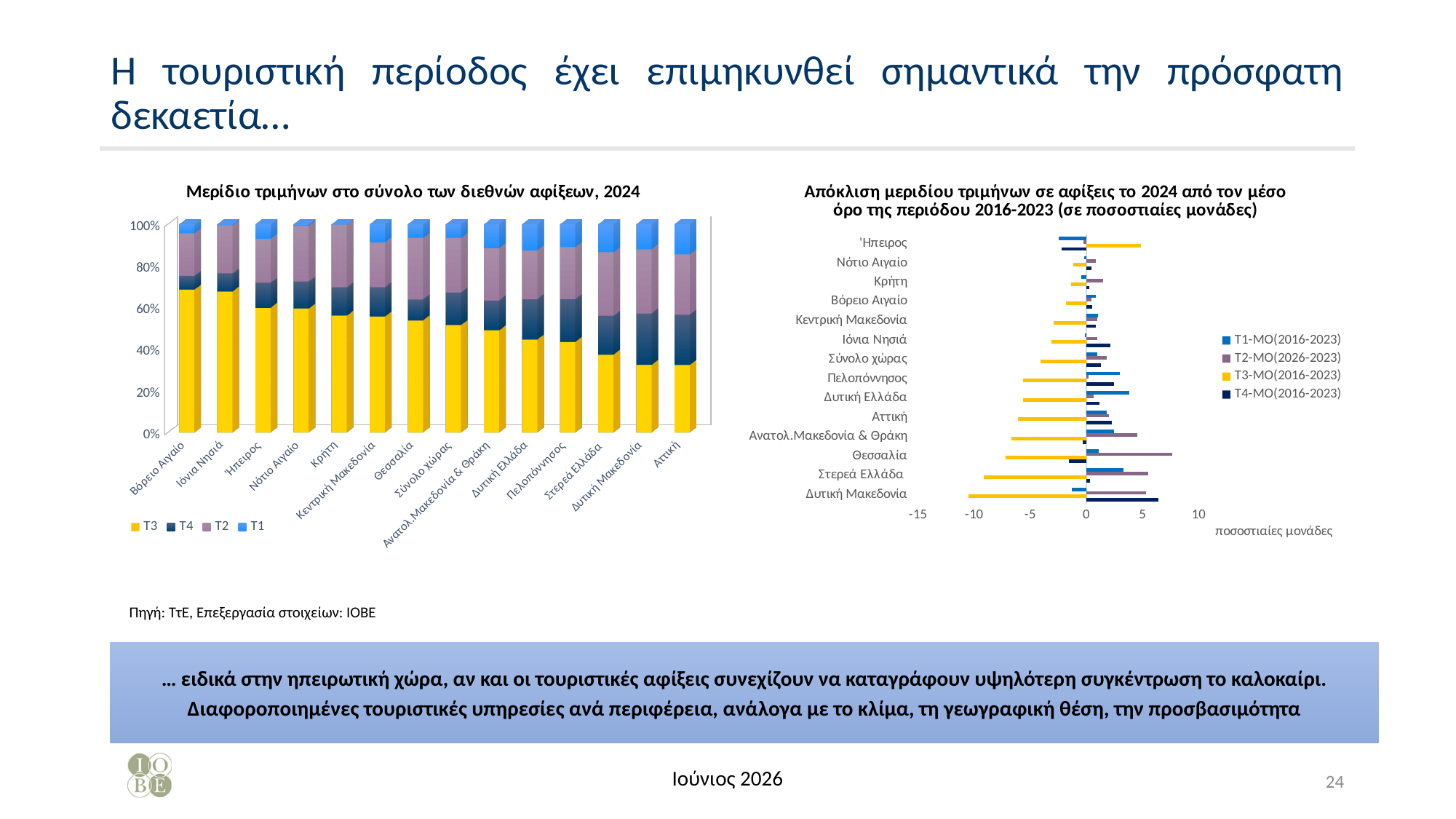
In the left chart 'Μερίδιο τριμήνων στο σύνολο των διεθνών αφίξεων, 2024', which has the larger Τ3 share: Βόρειο Αιγαίο or Αττική? Βόρειο Αιγαίο What kind of chart is the left chart titled 'Μερίδιο τριμήνων στο σύνολο των διεθνών αφίξεων, 2024'? Stacked bar chart In the left chart 'Μερίδιο τριμήνων στο σύνολο των διεθνών αφίξεων, 2024', how many series does the legend list? 4 What kind of chart is the right chart titled 'Απόκλιση μεριδίου τριμήνων σε αφίξεις το 2024 από τον μέσο όρο της περιόδου 2016-2023'? Bar chart In the right chart 'Απόκλιση μεριδίου τριμήνων σε αφίξεις το 2024 από τον μέσο όρο της περιόδου 2016-2023', which region has the lowest (most negative) Τ3-ΜΟ(2016-2023) value? Δυτική Μακεδονία In the left chart 'Μερίδιο τριμήνων στο σύνολο των διεθνών αφίξεων, 2024', does the Τ3 share rise or fall moving from left to right along the x axis? fall In the left chart 'Μερίδιο τριμήνων στο σύνολο των διεθνών αφίξεων, 2024', how many regions/categories are shown on the x axis? 14 In the left chart 'Μερίδιο τριμήνων στο σύνολο των διεθνών αφίξεων, 2024', is the Τ3 share for Αττική greater or less than 40%? less In the right chart 'Απόκλιση μεριδίου τριμήνων σε αφίξεις το 2024 από τον μέσο όρο της περιόδου 2016-2023', how many series does the legend list? 4 What is the x-axis label of the right chart 'Απόκλιση μεριδίου τριμήνων σε αφίξεις το 2024 από τον μέσο όρο της περιόδου 2016-2023'? ποσοστιαίες μονάδες In the left chart 'Μερίδιο τριμήνων στο σύνολο των διεθνών αφίξεων, 2024', is the Τ3 share for Βόρειο Αιγαίο greater or less than 60%? greater In the right chart 'Απόκλιση μεριδίου τριμήνων σε αφίξεις το 2024 από τον μέσο όρο της περιόδου 2016-2023', is the Τ2-ΜΟ value for Θεσσαλία greater or less than 5? greater